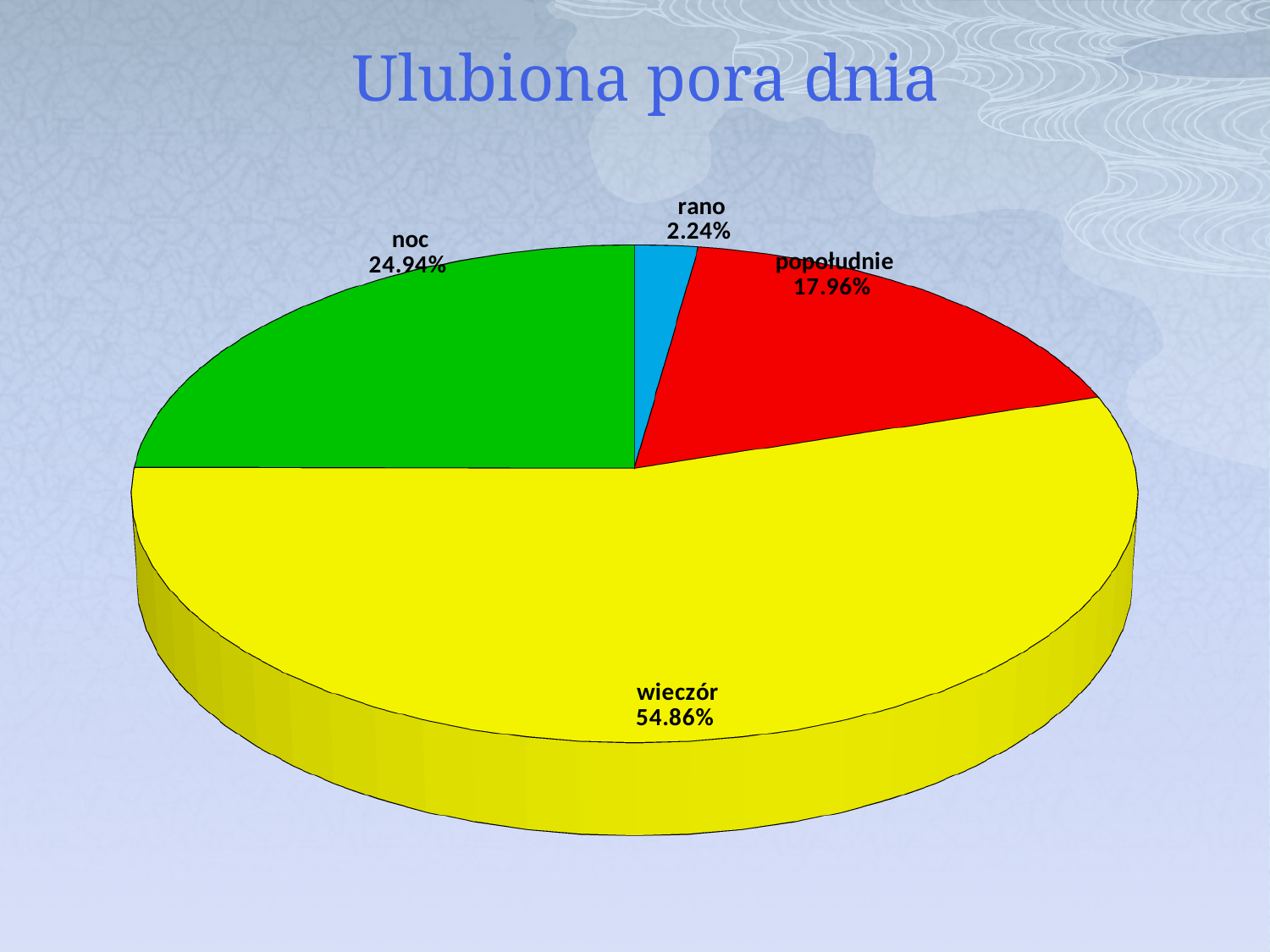
What is the title of the chart? Ulubiona pora dnia What is the share for popołudnie? 17.96% Which category has the largest slice? wieczór What is the share for rano? 2.24% Which is larger, the share for noc or the share for popołudnie? noc How many slices does the pie chart have? 4 What is the difference in percentage points between wieczór and noc? 29.92 What colour is the slice for noc? green What kind of chart is shown on the slide? pie chart Which category has the smallest slice? rano What is the share for noc? 24.94% What is the share for wieczór? 54.86%